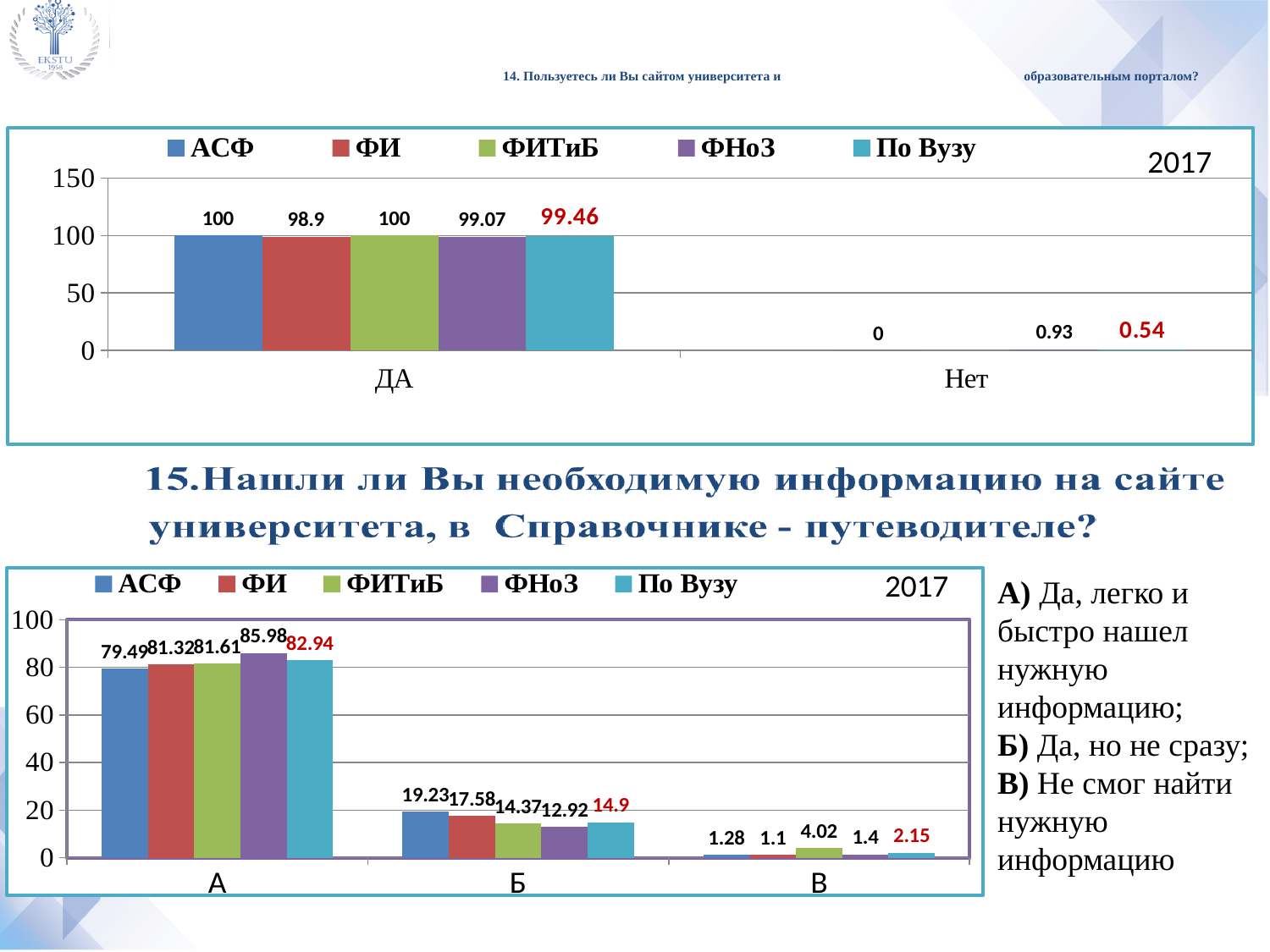
In the top chart (question 14), what is the value for По Вузу in the Нет category? 0.54 In the bottom chart (question 15), which series has the lowest value in category Б? ФНоЗ What type of chart is the bottom chart (question 15)? Bar chart In the bottom chart (question 15), which is larger in category В: the value for ФИ or the value for По Вузу? По Вузу In the top chart (question 14), what is the value for ФНоЗ in the ДА category? 99.07 In the top chart (question 14), how many series does the legend list? 5 In the bottom chart (question 15), which series has the highest value in category А? ФНоЗ In the top chart (question 14), what is the value for По Вузу in the ДА category? 99.46 In the bottom chart (question 15), what is the value for ФИТиБ in category В? 4.02 In the bottom chart (question 15), what is the value for ФНоЗ in category А? 85.98 In the top chart (question 14), what is the difference between the ДА values for АСФ and ФИ? 1.1 In the bottom chart (question 15), what is the difference between the АСФ and ФИ values in category Б? 1.65